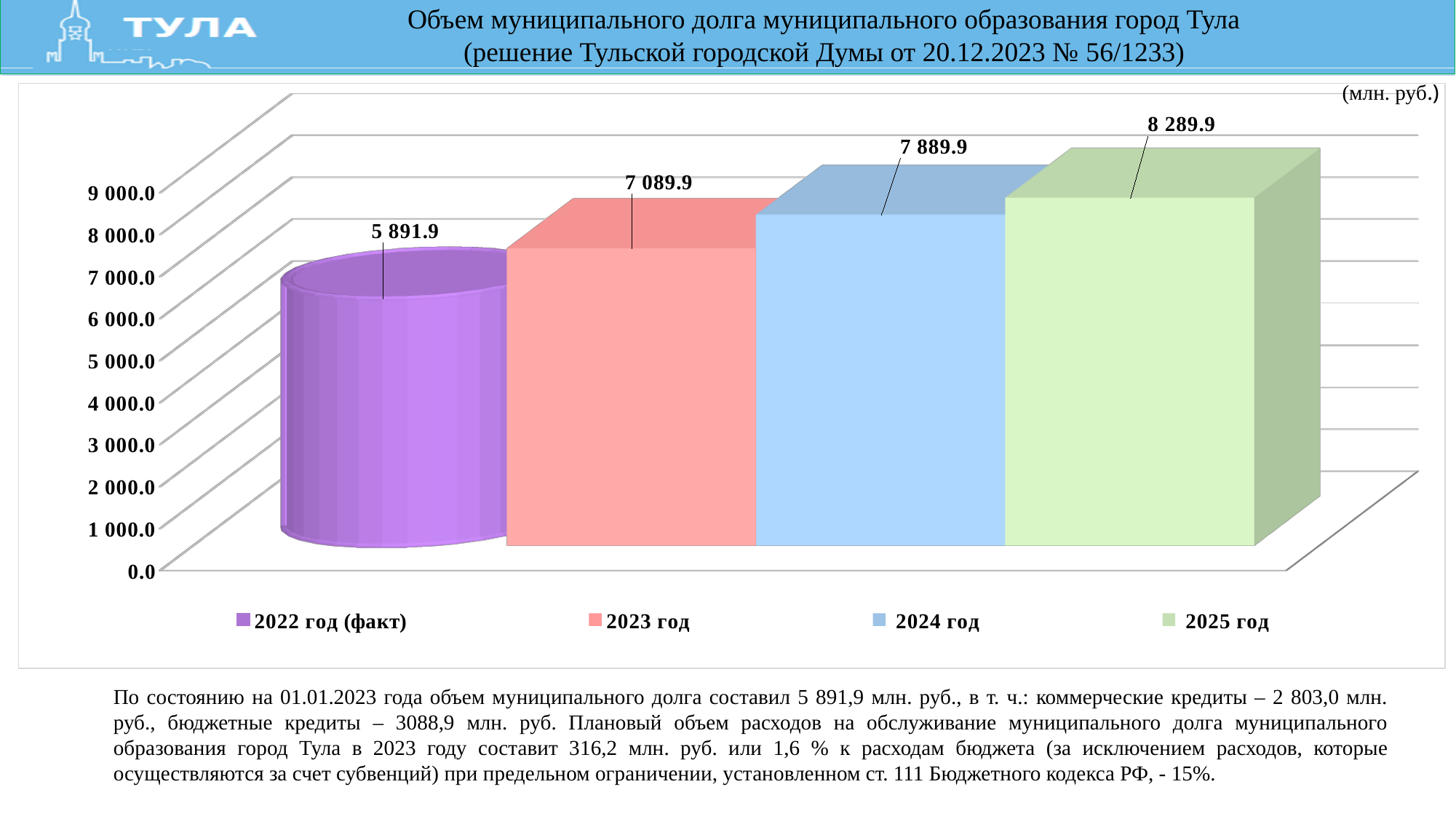
What is the value shown for 2024 год? 7 889.9 What is the value shown for 2025 год? 8 289.9 Which year has the highest value on the chart? 2025 год Which is larger, the value for 2023 год or the value for 2024 год? 2024 год Which year has the lowest value on the chart? 2022 год (факт) How many series does the legend list? 4 What is the difference between the values for 2025 год and 2024 год? 400.0 Do the values rise or fall from 2022 to 2025? rise What is the value shown for 2023 год? 7 089.9 What kind of chart is shown on the slide? bar chart What is the value shown for 2022 год (факт)? 5 891.9 What is the difference between the values for 2023 год and 2022 год (факт)? 1 198.0